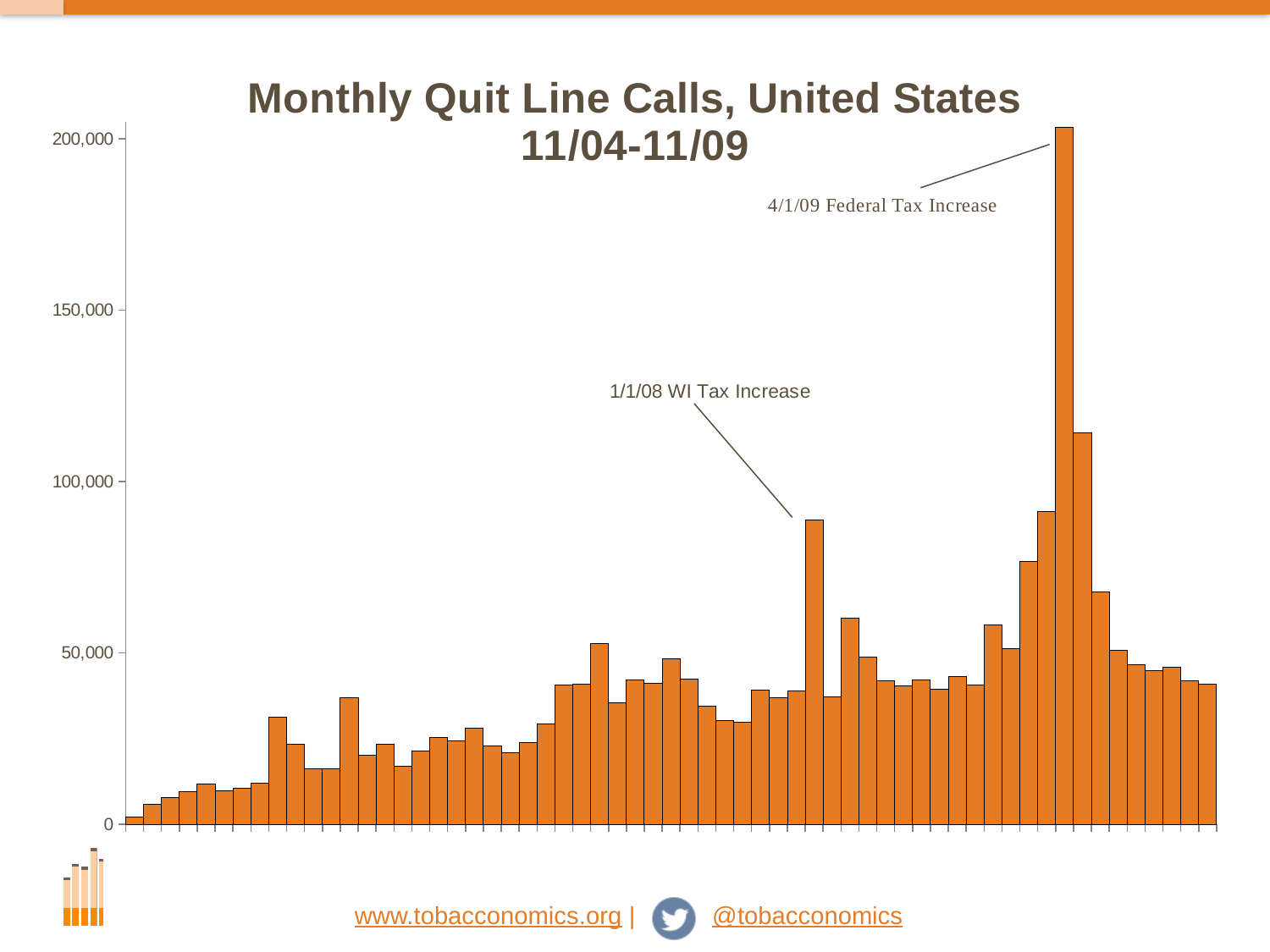
Is the value of the leftmost bar greater or less than 50,000? less Do the bars rise or fall in the months immediately after the bar annotated '4/1/09 Federal Tax Increase'? Fall Do the bar values generally rise or fall from the left of the chart to the right? Rise Which event is annotated at the tallest bar in the chart? 4/1/09 Federal Tax Increase Where is the lowest bar located in the chart? At the far left (the first bar) Is the value of the bar annotated '4/1/09 Federal Tax Increase' greater or less than 150,000? greater What is the title of the chart? Monthly Quit Line Calls, United States 11/04-11/09 What kind of chart is shown on the slide? Bar chart Is the value of the bar annotated '1/1/08 WI Tax Increase' greater or less than 50,000? greater Which bar is taller: the one annotated '1/1/08 WI Tax Increase' or the one annotated '4/1/09 Federal Tax Increase'? 4/1/09 Federal Tax Increase How many tax-increase events are annotated on the chart? 2